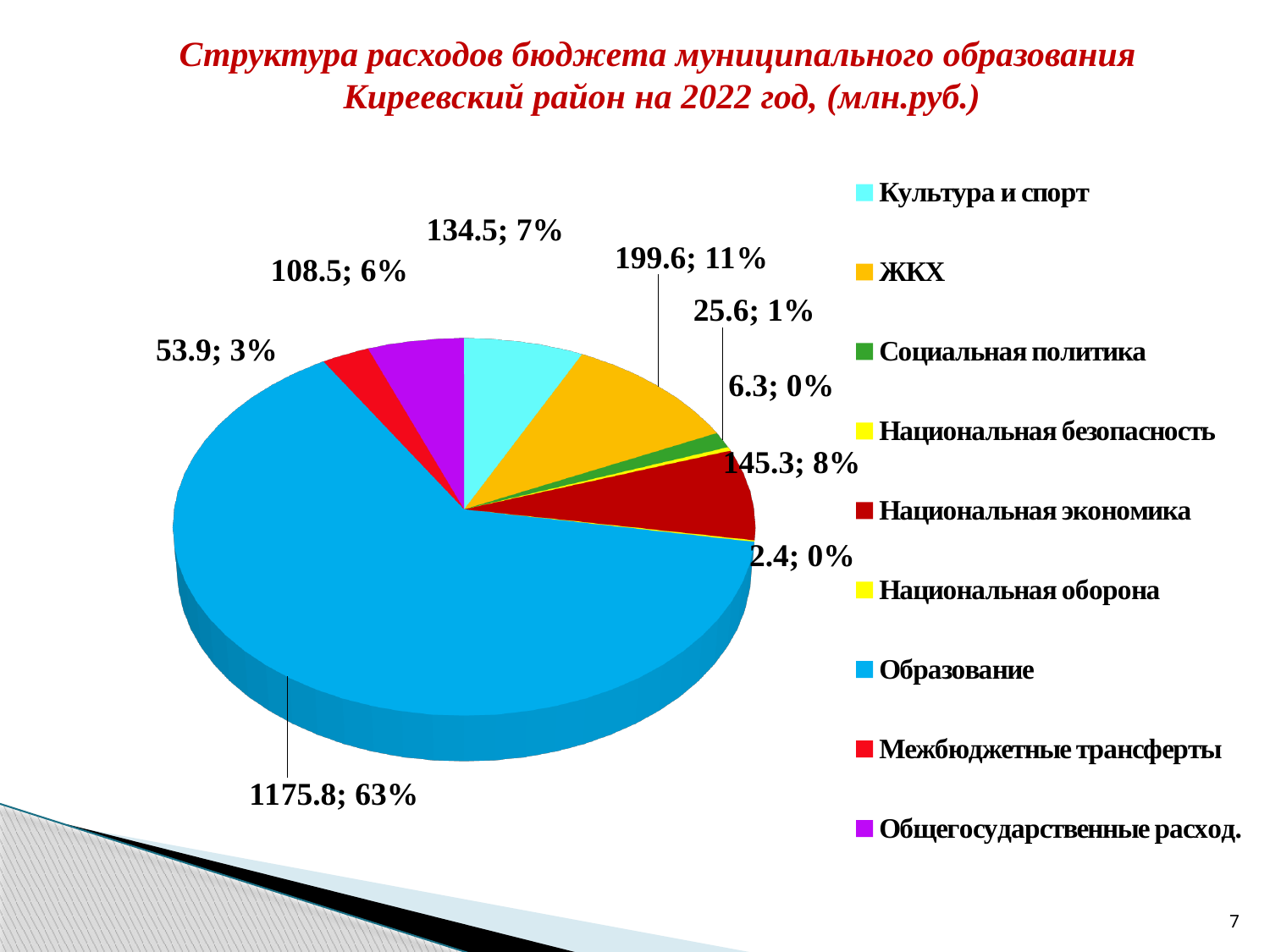
What is the difference between the values for ЖКХ and Национальная экономика? 54.3 Which category has the smallest value? Национальная оборона How many categories does the legend list? 9 What is the value for Национальная экономика? 145.3 What share of the pie does ЖКХ represent? 11% What is the value for Образование? 1175.8 What is the value for Культура и спорт? 134.5 Which is larger, the value for Общегосударственные расход. or the value for Межбюджетные трансферты? Общегосударственные расход. What is the value for ЖКХ? 199.6 What kind of chart is shown on the slide? pie chart Which category has the largest share of the pie? Образование What share of the pie does Образование represent? 63%